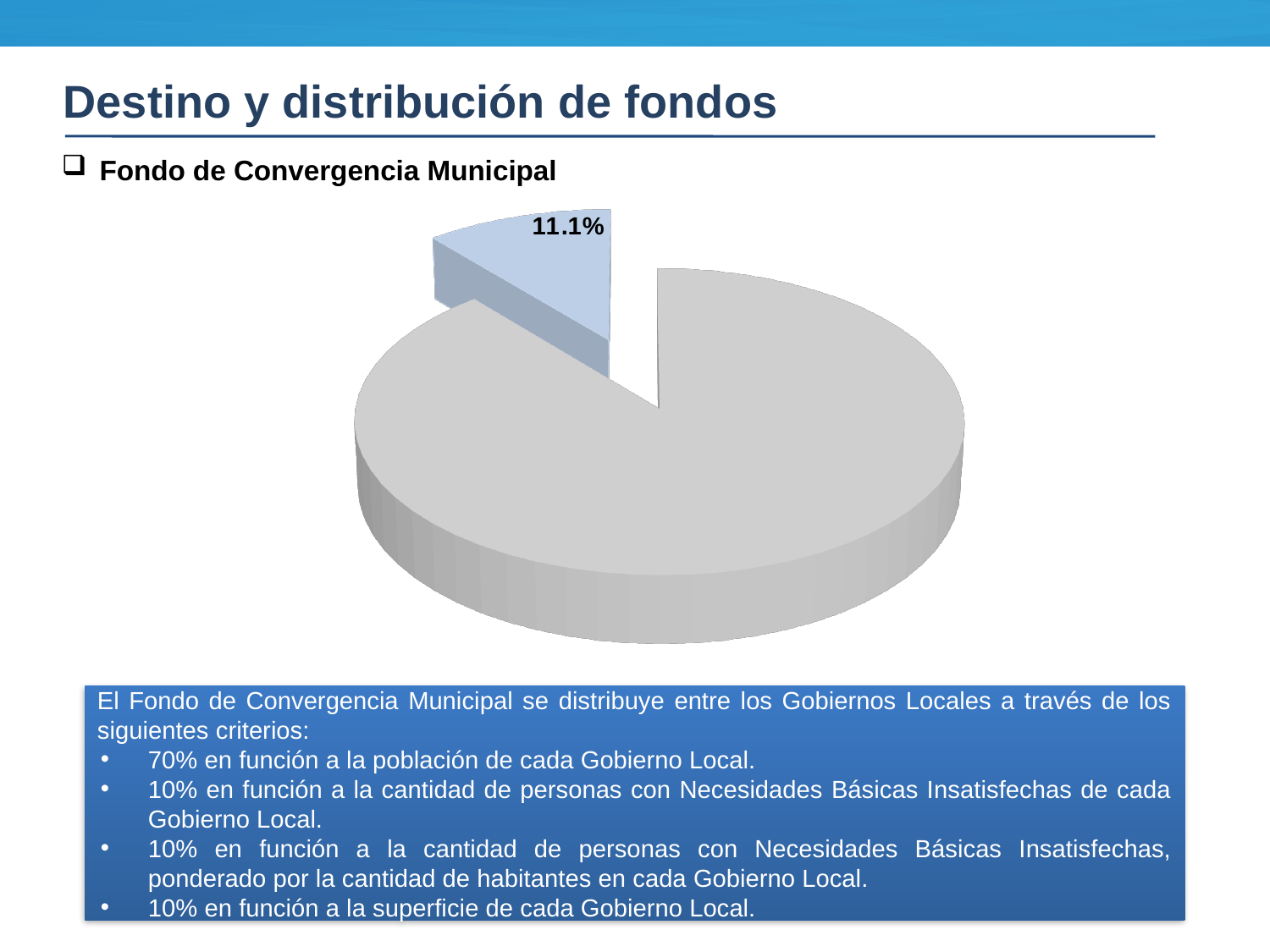
Which slice of the pie chart is larger, the grey slice or the light blue slice? the grey slice What share of the pie does the light blue slice represent? 11.1% What kind of chart is shown on the slide? pie chart How many slices of the pie chart have a data label printed? 1 How many slices does the pie chart have? 2 What percentage is printed on the small exploded slice of the pie chart? 11.1% What colour is the slice that is pulled out from the pie chart? light blue Is the value of the light blue slice greater or less than 50%? less Which slice of the pie chart is the smallest? the light blue slice (11.1%)